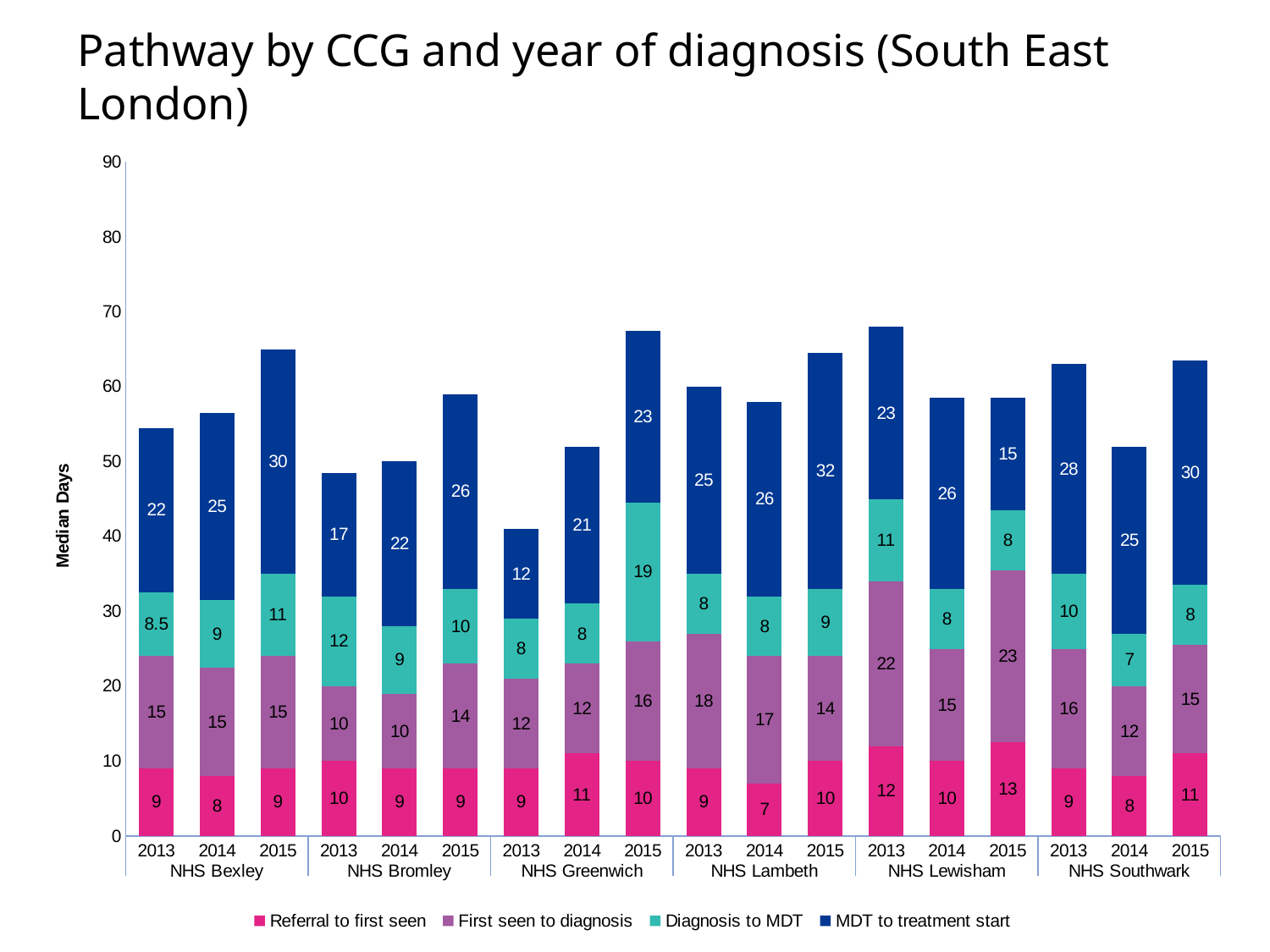
What is the median days for MDT to treatment start for NHS Lambeth in 2015? 32 What is the median days for Diagnosis to MDT for NHS Bexley in 2013? 8.5 How many series does the legend list? 4 What is the difference between the MDT to treatment start values for NHS Bexley in 2015 and 2013? 8 What is the total median days for NHS Greenwich in 2015? 68 What type of chart is shown on the slide? Stacked bar chart What is the median days for First seen to diagnosis for NHS Lewisham in 2015? 23 Which bar has the highest value for MDT to treatment start? NHS Lambeth 2015 Which bar has the lowest value for Referral to first seen? NHS Lambeth 2014 Which bar has the lowest total median days? NHS Greenwich 2013 How many bars are plotted in the chart? 18 Which is larger: Diagnosis to MDT for NHS Greenwich 2015 or for NHS Lewisham 2013? NHS Greenwich 2015